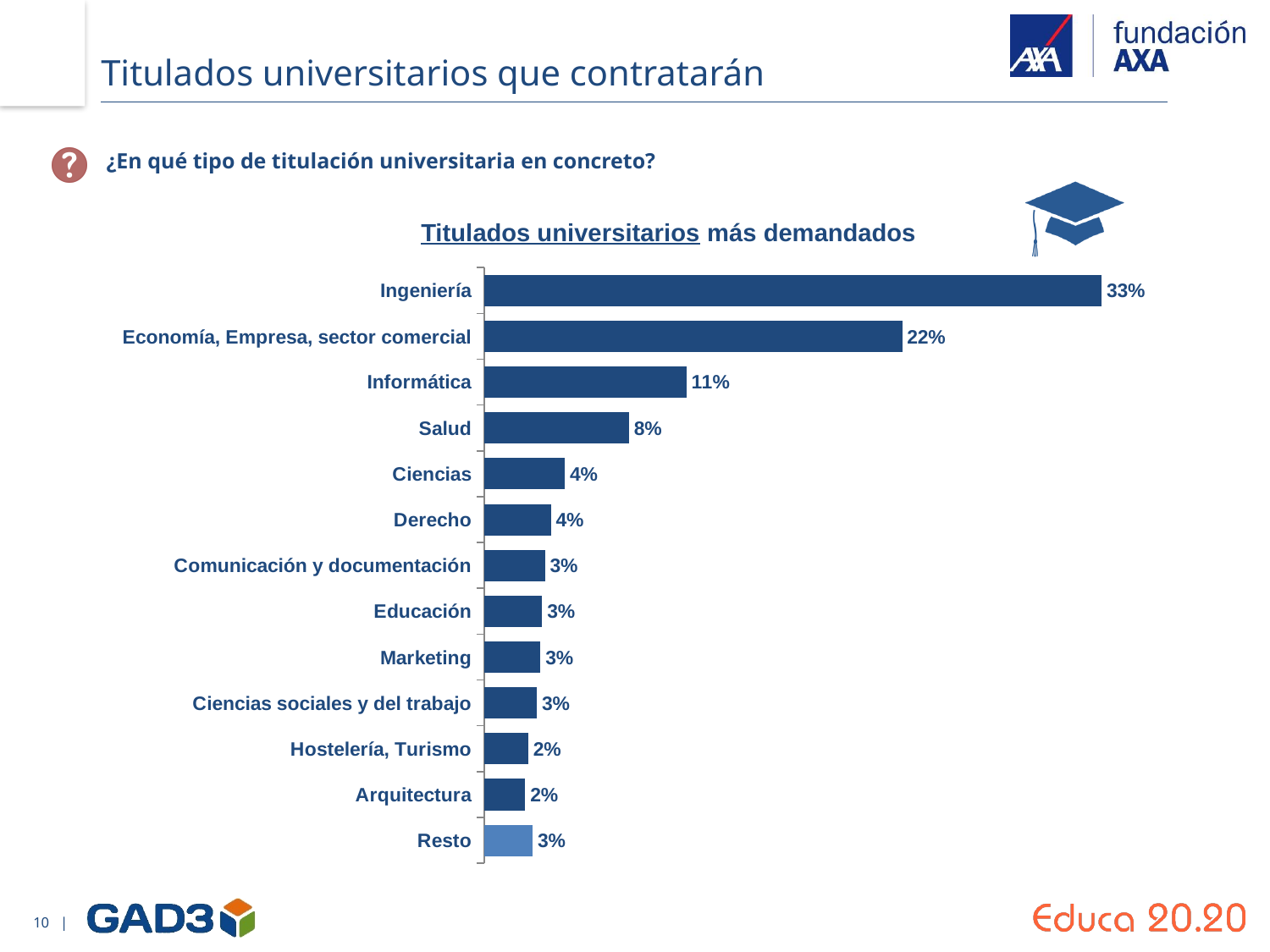
What is the value for Salud? 8% What is the title of the chart? Titulados universitarios más demandados What is the value for Hostelería, Turismo? 2% What kind of chart is shown on the slide? Bar chart What is the value for Informática? 11% How many categories are shown in the chart? 13 What is the value for Ingeniería? 33% What is the value for Economía, Empresa, sector comercial? 22% What is the difference between the values for Informática and Salud? 3% Which category has the highest value? Ingeniería Which is larger, the value for Salud or the value for Ciencias? Salud What is the difference between the values for Ingeniería and Economía, Empresa, sector comercial? 11%